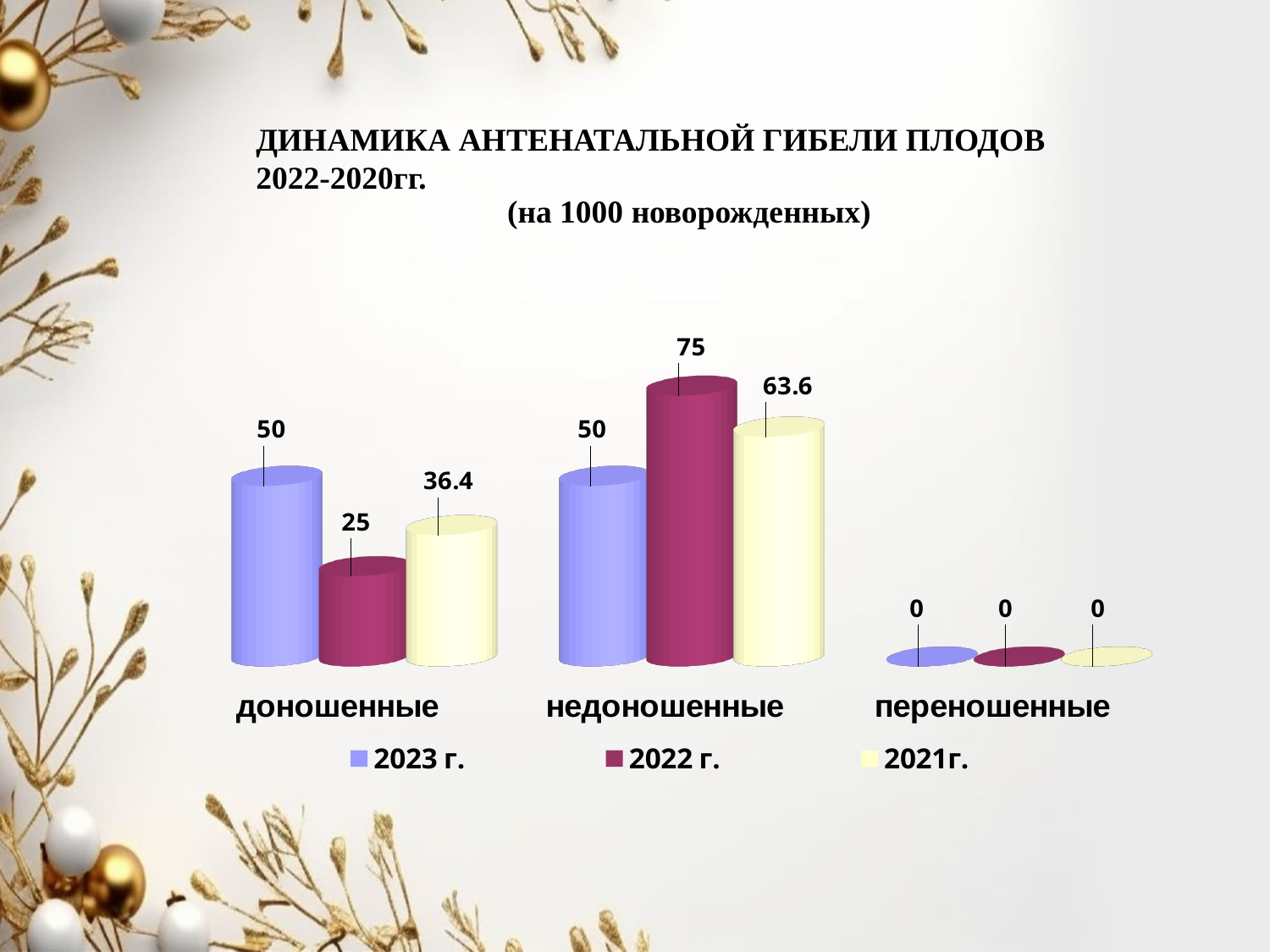
How many series does the legend list? 3 Which is larger for доношенные: the 2023 г. value or the 2021г. value? 2023 г. What is the value for доношенные in the 2021г. series? 36.4 What kind of chart is shown on the slide? bar chart Which series has the lowest value for доношенные? 2022 г. What is the value for недоношенные in the 2021г. series? 63.6 What is the value for переношенные in the 2022 г. series? 0 What is the value for недоношенные in the 2022 г. series? 75 How many categories are shown on the x axis? 3 What is the difference between the 2022 г. and 2023 г. values for недоношенные? 25 What is the value for доношенные in the 2023 г. series? 50 Which category has the highest value in the 2022 г. series? недоношенные